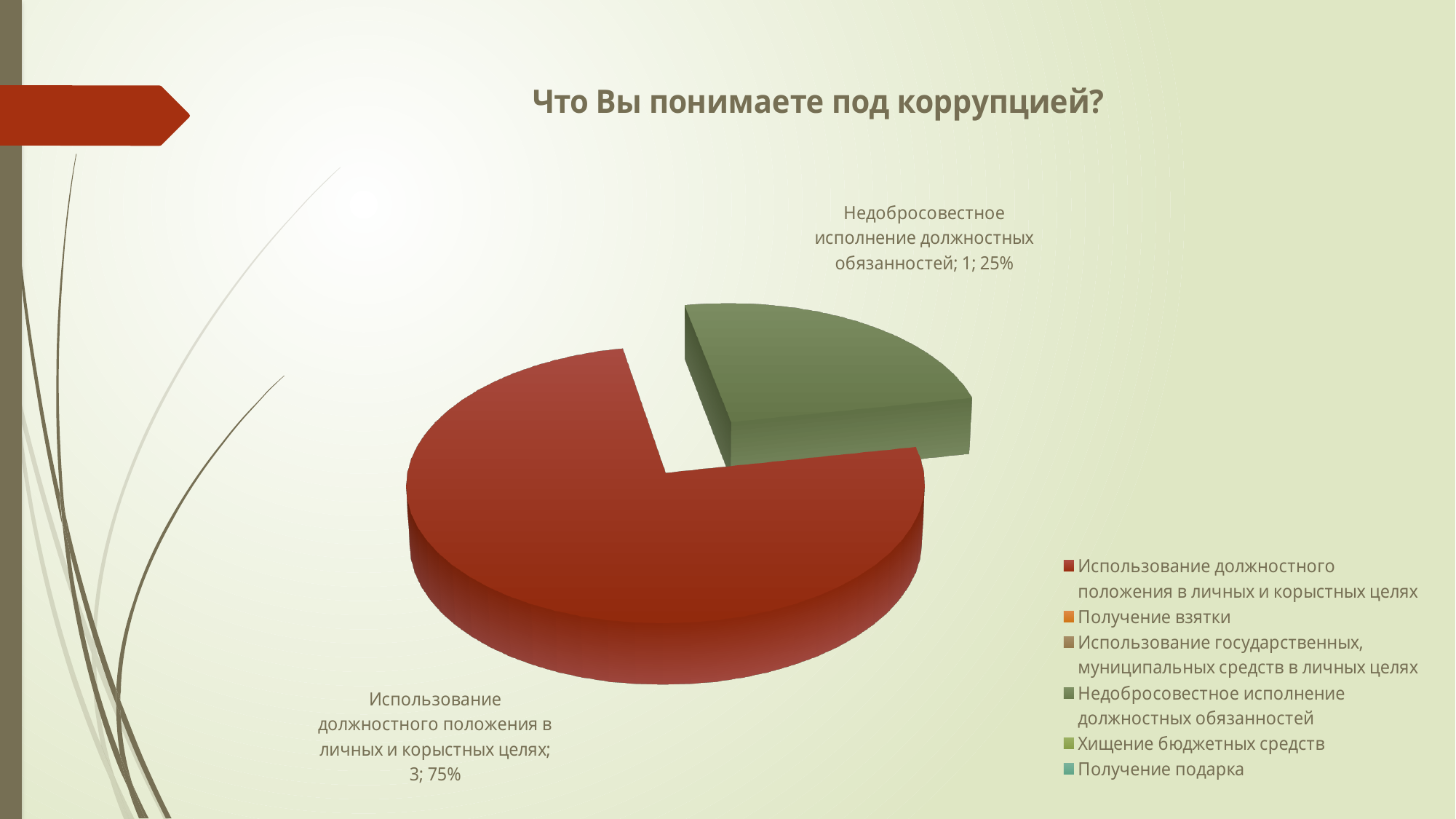
What share of the pie does "Недобросовестное исполнение должностных обязанностей" take? 25% What colour is the slice for "Недобросовестное исполнение должностных обязанностей"? Green Which of the two labelled slices is smaller? Недобросовестное исполнение должностных обязанностей What is the difference in percentage points between the two labelled slices? 50 percentage points Which category has the largest slice of the pie? Использование должностного положения в личных и корыстных целях How many slices with data labels are visible in the pie? 2 How many entries does the legend list? 6 What is the count value shown for "Недобросовестное исполнение должностных обязанностей"? 1 What kind of chart is shown on the slide? Pie chart What is the count value shown for "Использование должностного положения в личных и корыстных целях"? 3 What is the title of the chart? Что Вы понимаете под коррупцией? What share of the pie does "Использование должностного положения в личных и корыстных целях" take? 75%